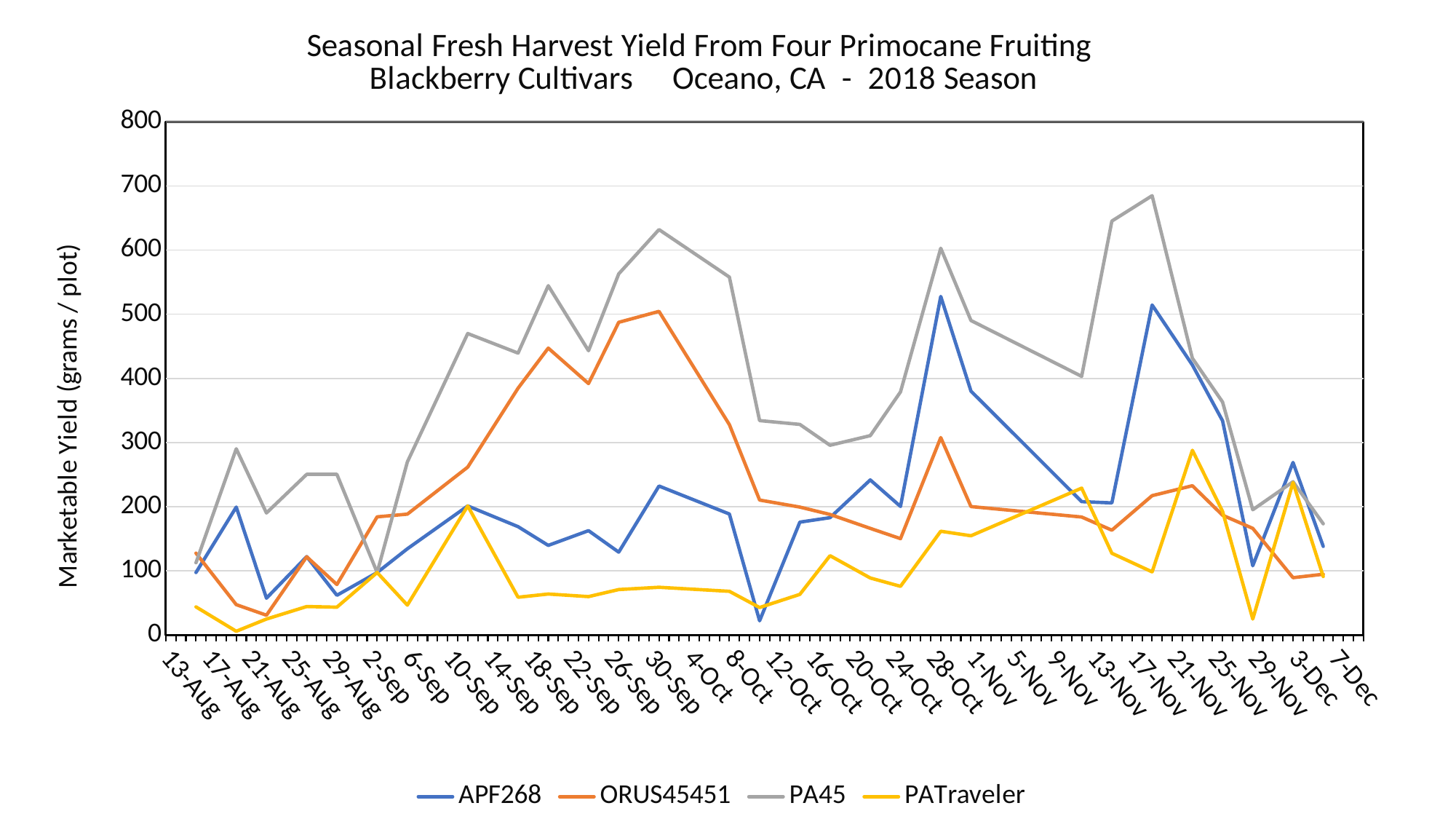
Is the value for APF268 on 12-Oct greater or less than 100? less Which cultivar is shown by the grey line in the legend? PA45 On 30-Sep, which is larger: the value for PA45 or the value for APF268? PA45 What is the label of the y axis? Marketable Yield (grams / plot) How many series does the legend list? 4 Which series has the lowest value on 17-Aug? PATraveler What kind of chart is shown on the slide? Line chart Does the PA45 line rise or fall between 2-Sep and 30-Sep? rise Which series reaches the highest value anywhere on the chart? PA45 Is the value for ORUS45451 on 30-Sep greater or less than 400? greater Is the value for PA45 on 17-Nov greater or less than 600? greater